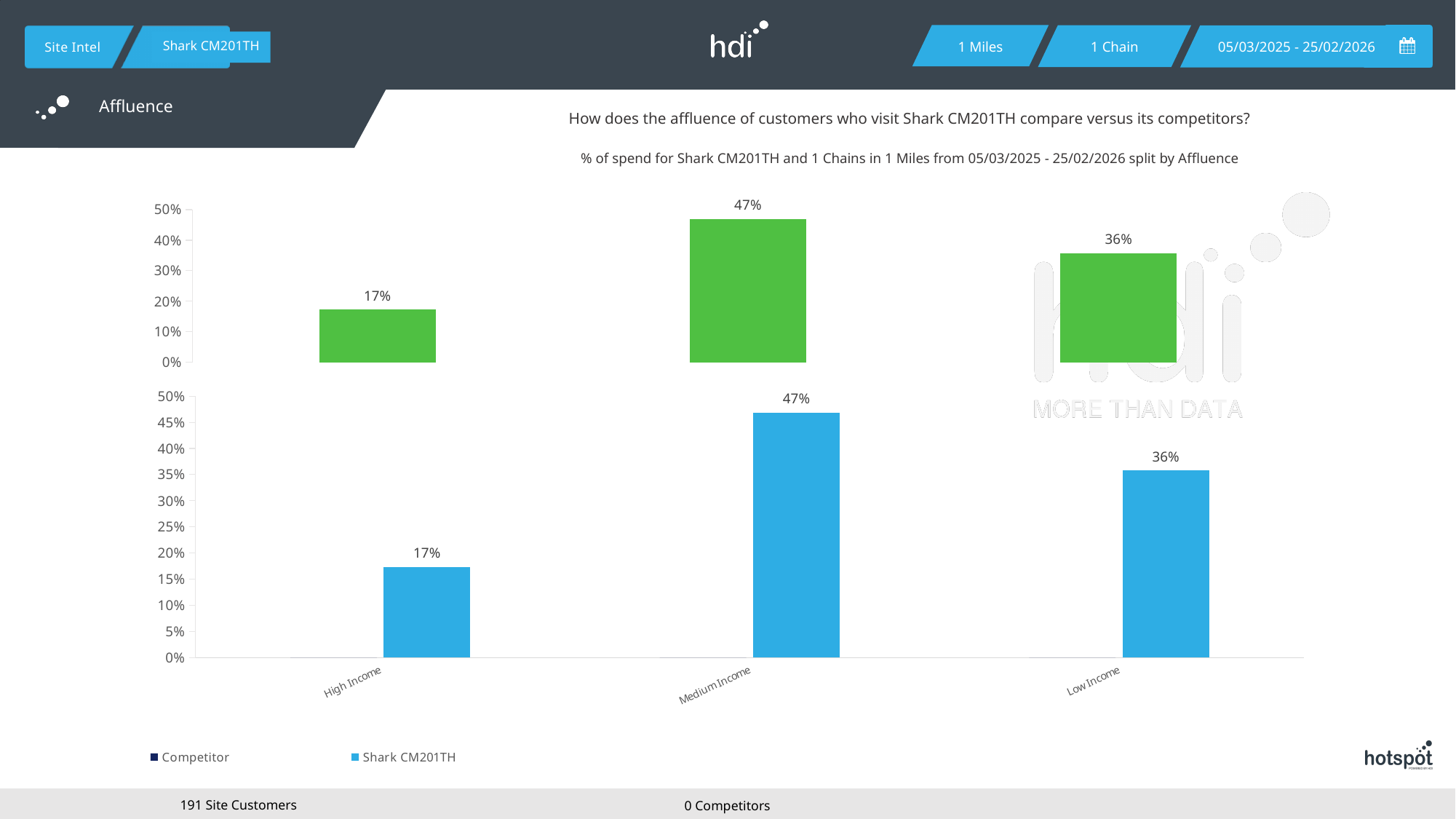
In the bottom chart, which category has the lowest value? High Income In the bottom chart, what is the difference between the Medium Income and Low Income values? 11% In the bottom chart, which category has the highest value? Medium Income In the bottom chart, what is the value for High Income? 17% In the bottom chart, which is larger, the value for Low Income or the value for High Income? Low Income In the bottom chart, is the value for Low Income greater or less than 30%? greater What type of chart is the bottom chart? bar chart In the bottom chart, what is the value for Medium Income? 47% How many categories are shown on the x axis of the bottom chart? 3 In the bottom chart, what is the value for Low Income? 36% In the bottom chart, what is the difference between the Low Income and High Income values? 19% How many series does the legend at the bottom of the slide list? 2